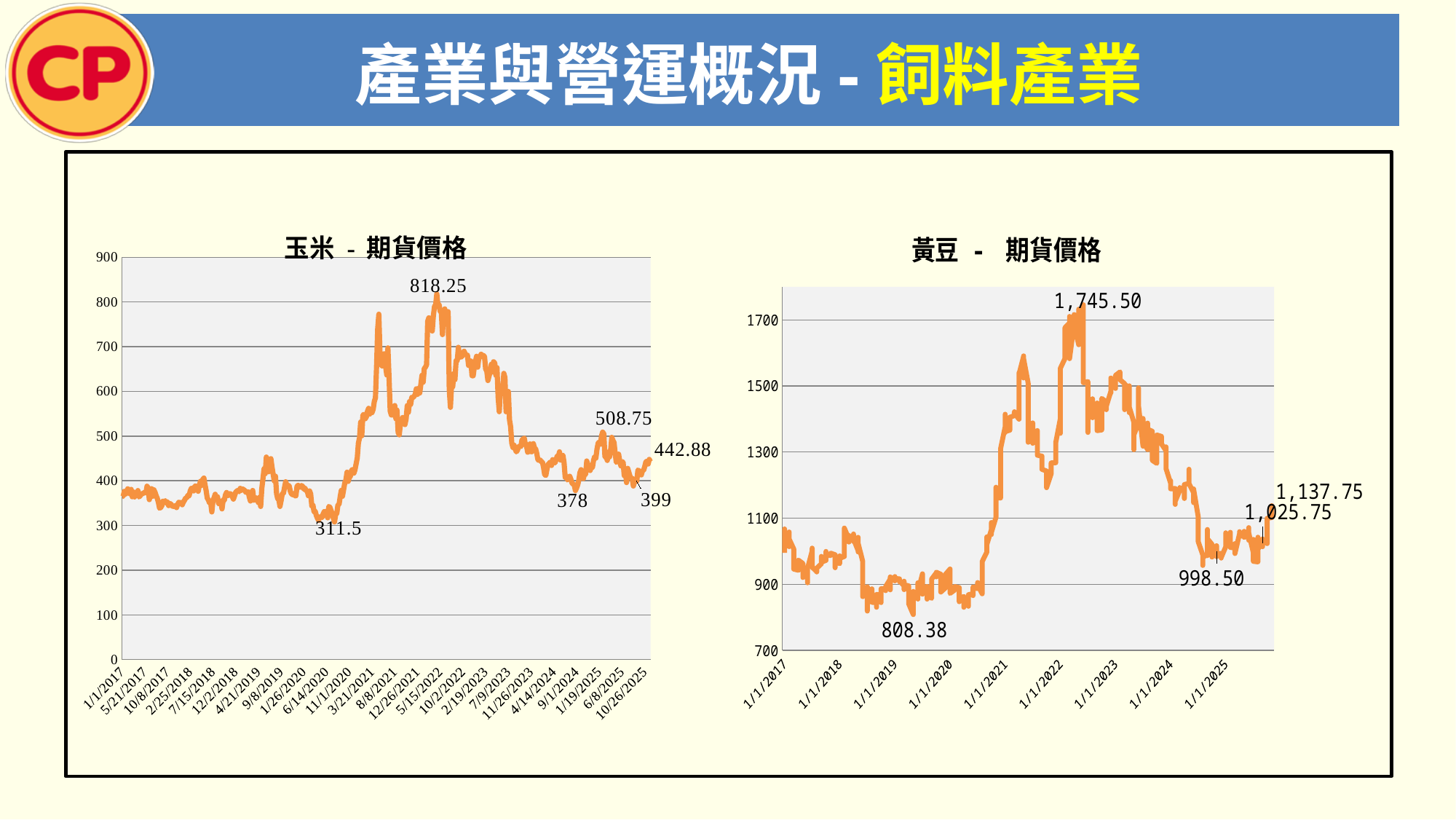
In the 玉米 - 期貨價格 chart, what is the lowest labeled price? 311.5 How many charts are shown on the slide? 2 In the 黃豆 - 期貨價格 chart, what is the difference between the peak label 1,745.50 and the low label 808.38? 937.12 In the 黃豆 - 期貨價格 chart, what is the lowest labeled price? 808.38 In the 玉米 - 期貨價格 chart, what is the difference between the peak label 818.25 and the low label 311.5? 506.75 In the 玉米 - 期貨價格 chart, what is the highest labeled price? 818.25 In the 玉米 - 期貨價格 chart, which labeled value is larger, 508.75 or 442.88? 508.75 In the 黃豆 - 期貨價格 chart, what is the highest labeled price? 1,745.50 What kind of chart is the 玉米 - 期貨價格 chart on the left? line chart In the 玉米 - 期貨價格 chart, is the value at 1/1/2017 greater or less than 300? greater In the 黃豆 - 期貨價格 chart, is the value at 1/1/2020 greater or less than 1100? less In the 玉米 - 期貨價格 chart, what is the last labeled value at the right end of the line? 442.88